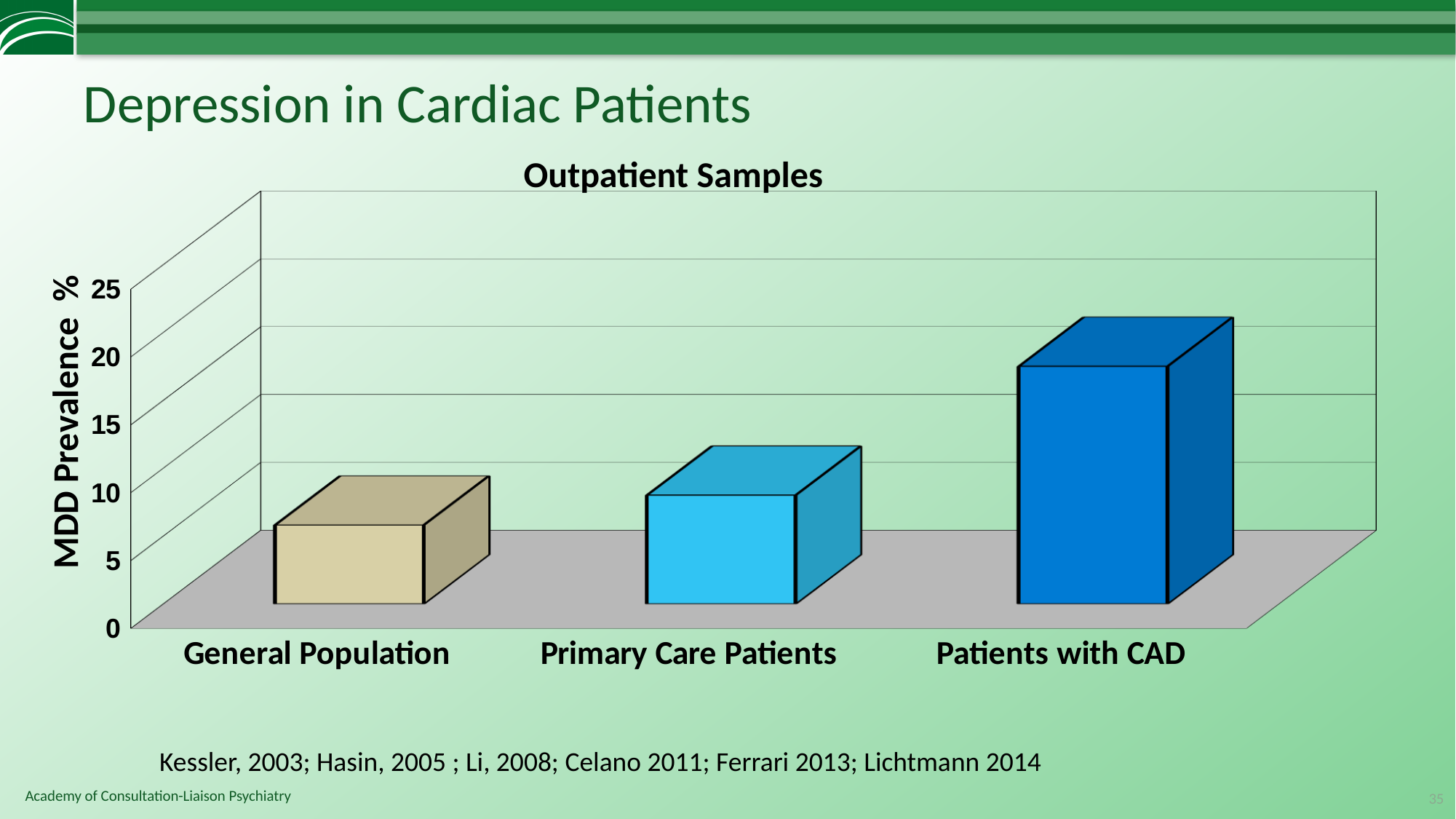
Is the value for General Population greater or less than 10? less Is the value for Primary Care Patients greater or less than 15? less Which category has the lowest MDD prevalence? General Population Is the value for General Population greater or less than 5? greater Which is larger, the value for Primary Care Patients or the value for General Population? Primary Care Patients What kind of chart is shown on the slide? bar chart Which category has the highest MDD prevalence? Patients with CAD Do the values rise or fall from left to right across the categories? rise How many categories are shown on the x axis of the chart? 3 What is the title of the chart? Outpatient Samples Which is larger, the value for Patients with CAD or the value for Primary Care Patients? Patients with CAD